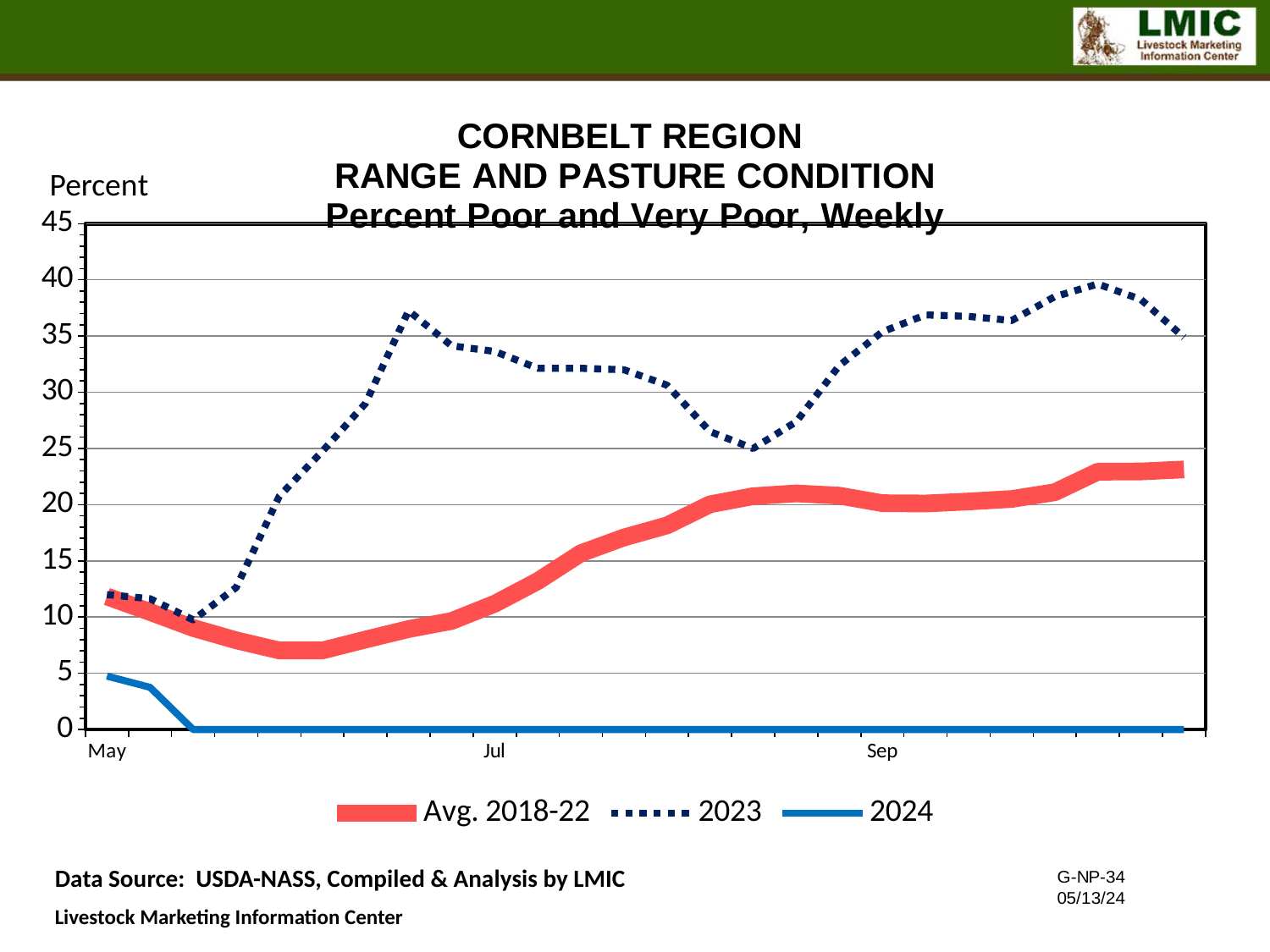
Is the value for Avg. 2018-22 at the end of the series greater or less than 20? greater Is the highest value of the 2023 series greater or less than 35? greater Does the 2024 series rise or fall from May onward? fall Which series are listed in the legend? Avg. 2018-22, 2023, 2024 Is the value for 2024 at May greater or less than 10? less What is the label on the vertical axis? Percent How many series does the legend list? 3 At May, which series has the larger value, 2024 or Avg. 2018-22? Avg. 2018-22 What kind of chart is shown on the slide? line chart Which series has the lowest value at Jul? 2024 At Sep, which series has the larger value, 2023 or Avg. 2018-22? 2023